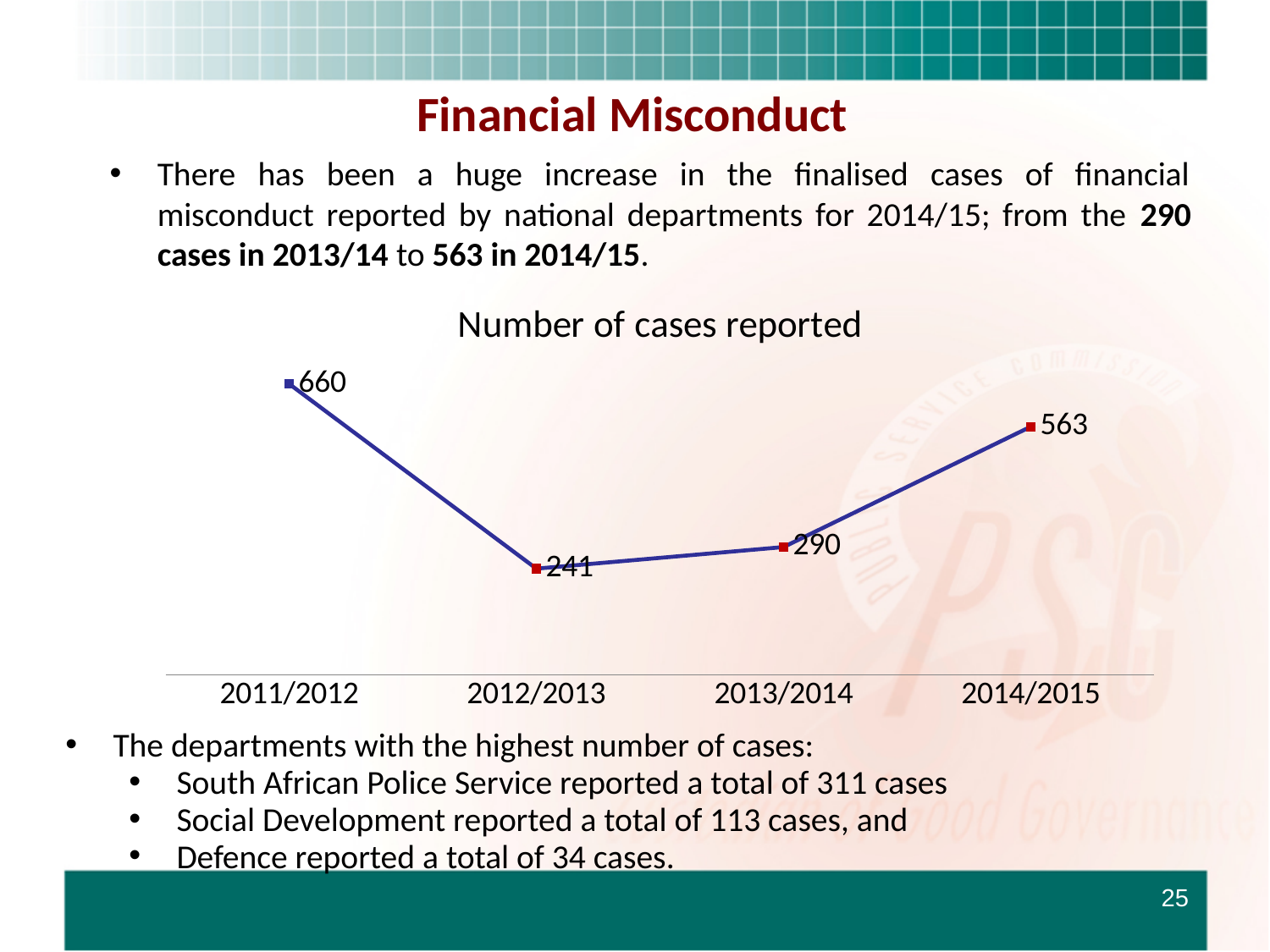
Which year has the highest number of cases reported? 2011/2012 What is the title of the chart? Number of cases reported What is the difference in cases reported between 2011/2012 and 2012/2013? 419 What kind of chart is shown on the slide? Line chart What is the difference in cases reported between 2014/2015 and 2013/2014? 273 What is the number of cases reported for 2012/2013? 241 Which year had more cases reported, 2011/2012 or 2014/2015? 2011/2012 Which year has the lowest number of cases reported? 2012/2013 What is the number of cases reported for 2013/2014? 290 How many years are plotted on the chart? 4 What is the number of cases reported for 2014/2015? 563 What is the number of cases reported for 2011/2012? 660